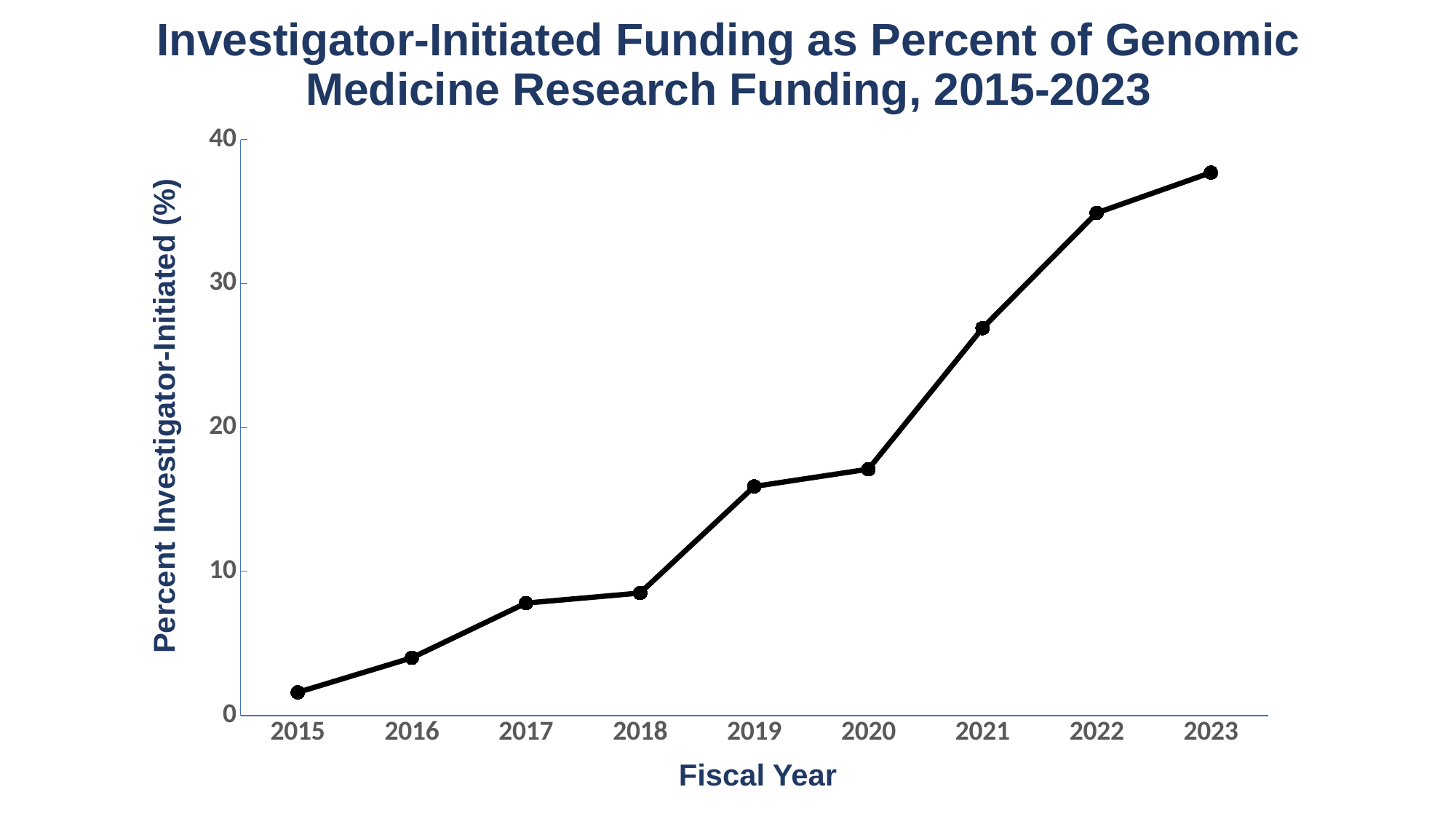
Which is larger, the value for 2019 or the value for 2021? 2021 What kind of chart is shown on the slide? line chart Is the value for 2022 greater or less than 30? greater Do the values generally rise or fall from 2015 to 2023? rise Which fiscal year has the lowest percent of investigator-initiated funding? 2015 What is the label of the x axis? Fiscal Year Is the value for 2021 greater or less than 20? greater What is the label of the y axis? Percent Investigator-Initiated (%) Which fiscal year has the highest percent of investigator-initiated funding? 2023 How many fiscal years are plotted on the chart? 9 Is the value for 2017 greater or less than 10? less